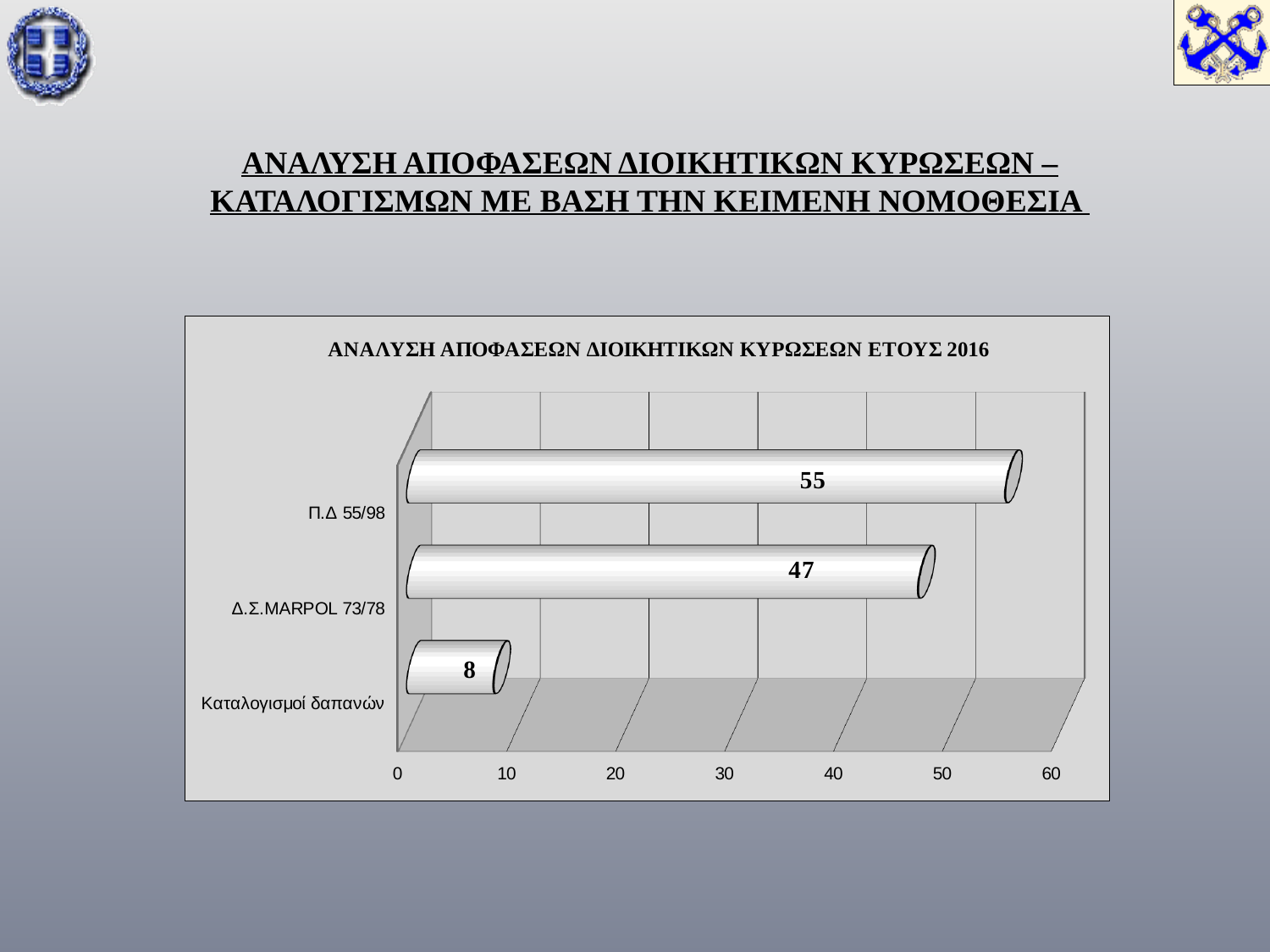
Which category has the lowest value? Καταλογισμοί δαπανών Which category has the highest value? Π.Δ 55/98 What kind of chart is shown on the slide? bar chart What is the value for Δ.Σ.MARPOL 73/78? 47 What is the value for Π.Δ 55/98? 55 Which is larger, the value for Δ.Σ.MARPOL 73/78 or the value for Καταλογισμοί δαπανών? Δ.Σ.MARPOL 73/78 What is the difference between the values for Δ.Σ.MARPOL 73/78 and Καταλογισμοί δαπανών? 39 How many categories are shown in the chart? 3 What is the difference between the values for Π.Δ 55/98 and Δ.Σ.MARPOL 73/78? 8 What is the title of the chart? ΑΝΑΛΥΣΗ ΑΠΟΦΑΣΕΩΝ ΔΙΟΙΚΗΤΙΚΩΝ ΚΥΡΩΣΕΩΝ ΕΤΟΥΣ 2016 Is the value for Δ.Σ.MARPOL 73/78 greater or less than 40? greater What is the value for Καταλογισμοί δαπανών? 8